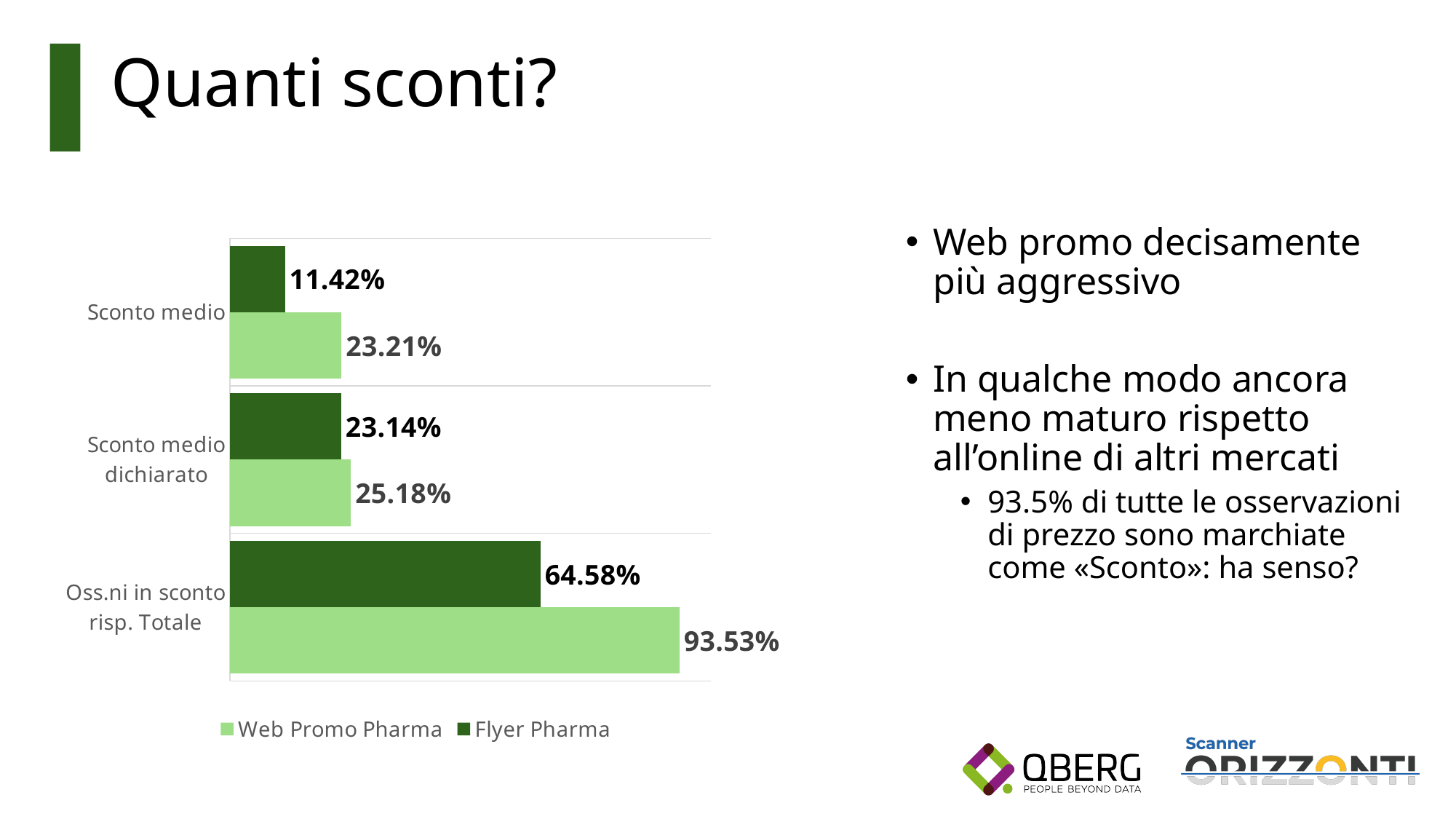
What is the value for Web Promo Pharma in the 'Sconto medio' category? 23.21% How many categories are shown on the chart? 3 What kind of chart is shown on the slide? Bar chart What is the value for Flyer Pharma in the 'Sconto medio' category? 11.42% How many series does the legend list? 2 Which category has the highest value for Web Promo Pharma? Oss.ni in sconto risp. Totale Which category has the lowest value for Flyer Pharma? Sconto medio In the 'Sconto medio dichiarato' category, which series has the larger value, Web Promo Pharma or Flyer Pharma? Web Promo Pharma What is the value for Web Promo Pharma in the 'Sconto medio dichiarato' category? 25.18% What is the value for Flyer Pharma in the 'Oss.ni in sconto risp. Totale' category? 64.58% What is the difference between Web Promo Pharma and Flyer Pharma in the 'Sconto medio' category? 11.79% What is the difference between Web Promo Pharma and Flyer Pharma in the 'Oss.ni in sconto risp. Totale' category? 28.95%